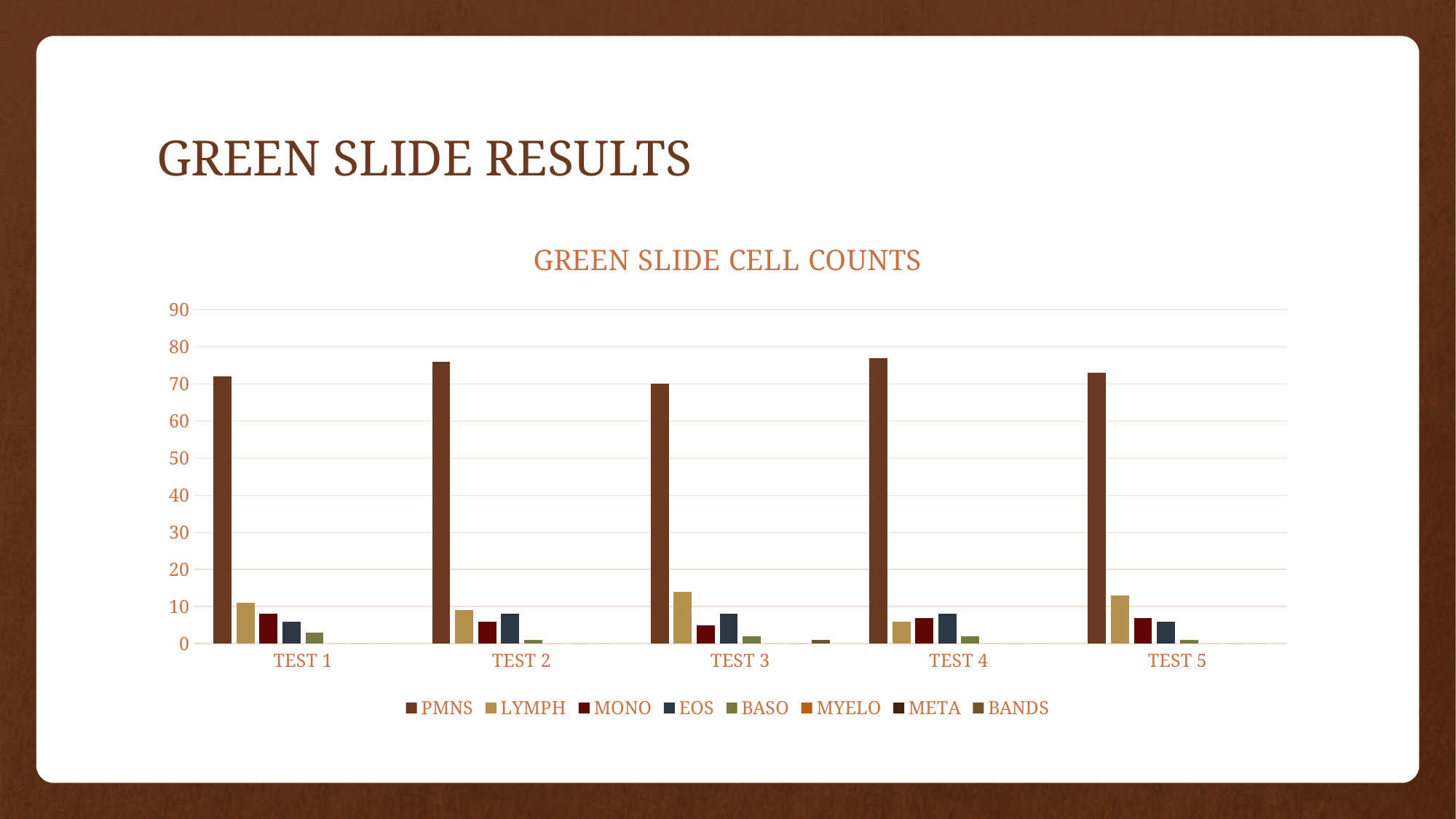
Among the five tests, which has the lowest LYMPH value? TEST 4 Which series has the tallest bar in TEST 2? PMNS How many series does the legend list? 8 Is the LYMPH value for TEST 3 greater or less than 10? greater In TEST 3, which is larger, LYMPH or MONO? LYMPH How many test categories are shown on the x axis? 5 What kind of chart is shown on the slide? bar chart Is the PMNS value for TEST 1 greater or less than 60? greater Is the PMNS value for TEST 4 greater or less than 80? less What is the title of the chart? GREEN SLIDE CELL COUNTS Which series has the tallest bar in every test? PMNS